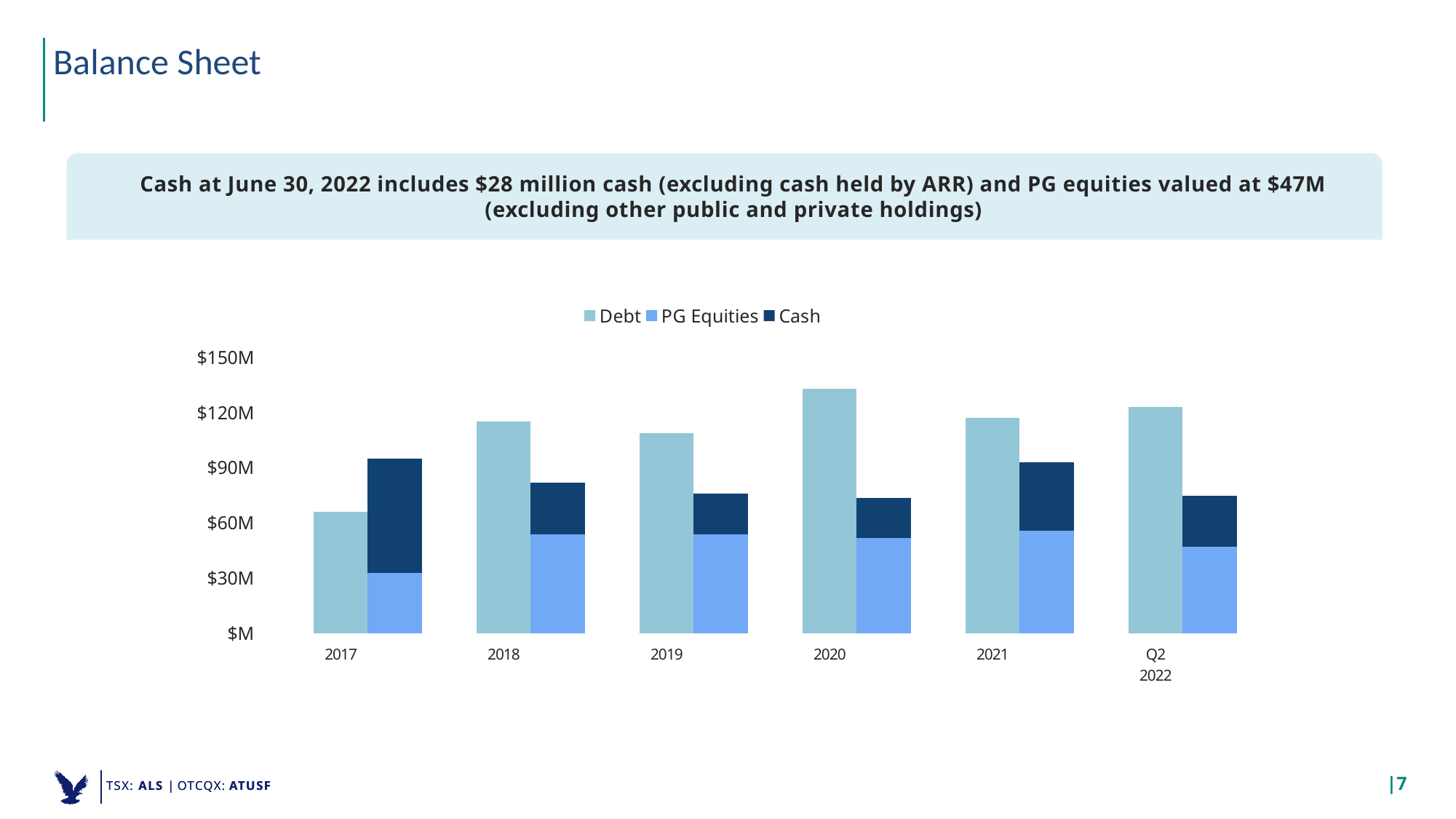
Which period has the lowest Debt bar? 2017 How many series does the legend list? 3 Which period has the highest Debt bar? 2020 Is the Debt value for 2019 greater or less than $90M? greater Is the Debt value for 2020 greater or less than $120M? greater How many time periods are shown on the x axis? 6 Does the Debt value rise or fall from 2017 to 2018? rise What kind of chart is shown on the slide? bar chart Which is larger, the Debt value for 2020 or for 2021? 2020 Which period has the lowest PG Equities value? 2017 Which series are listed in the legend? Debt, PG Equities, Cash Is the Debt value for 2017 greater or less than $90M? less